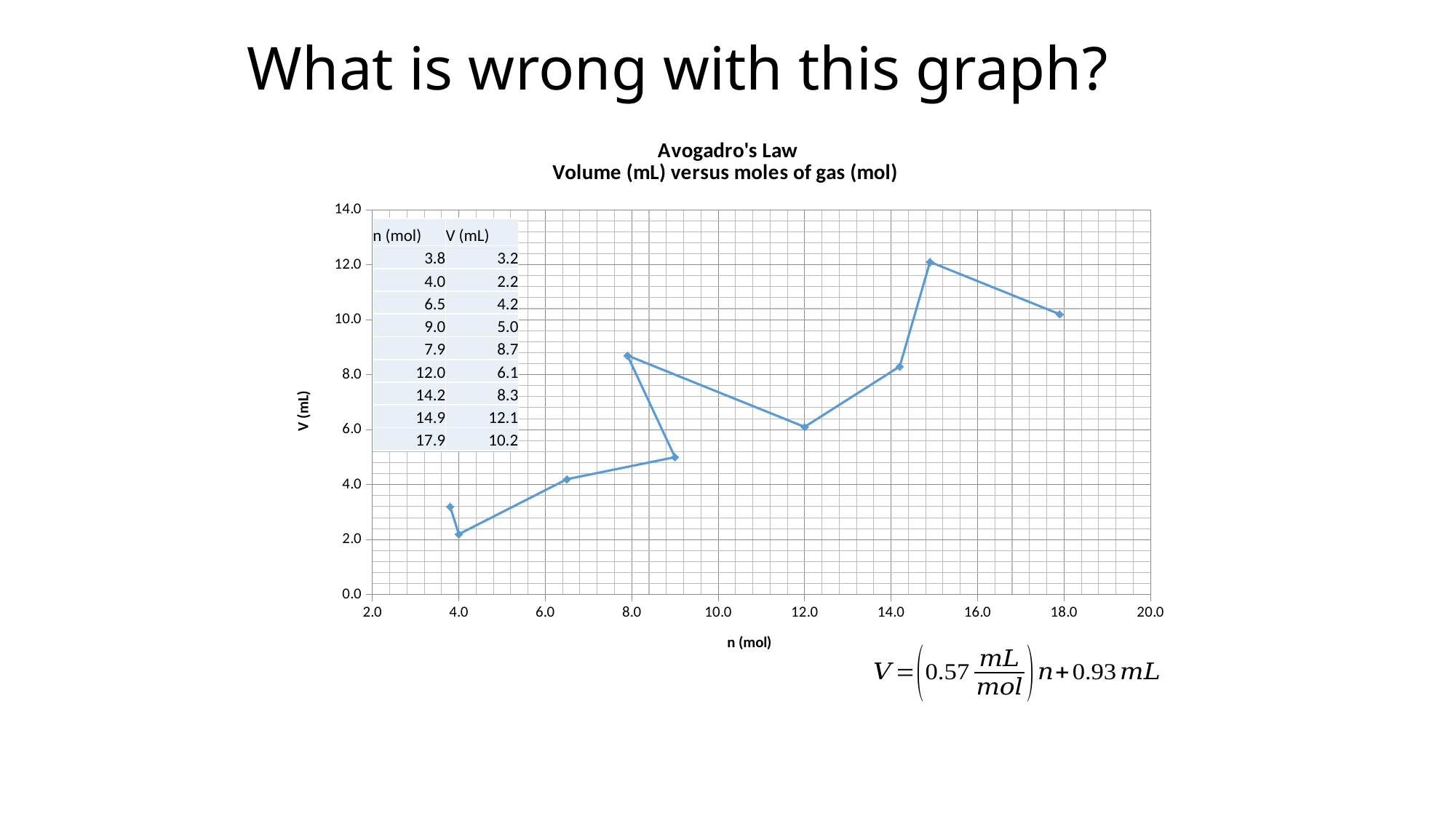
Is the volume at n = 14.9 mol greater or less than 10.0 mL? greater Which has the larger volume: the point at n = 7.9 mol or the point at n = 12.0 mol? n = 7.9 mol What kind of chart is shown on the slide? Line chart What is the volume V (mL) recorded for n = 17.9 mol? 10.2 What is the label of the vertical axis of the chart? V (mL) At which value of n (mol) is the volume highest? 14.9 What is the volume V (mL) recorded for n = 9.0 mol? 5.0 What is the slope value given in the equation below the chart? 0.57 mL/mol What is the lowest volume V (mL) plotted on the chart? 2.2 What is the volume V (mL) recorded for n = 14.2 mol? 8.3 What is the difference in volume between the points at n = 14.9 mol and n = 17.9 mol? 1.9 mL How many data points are plotted on the chart? 9